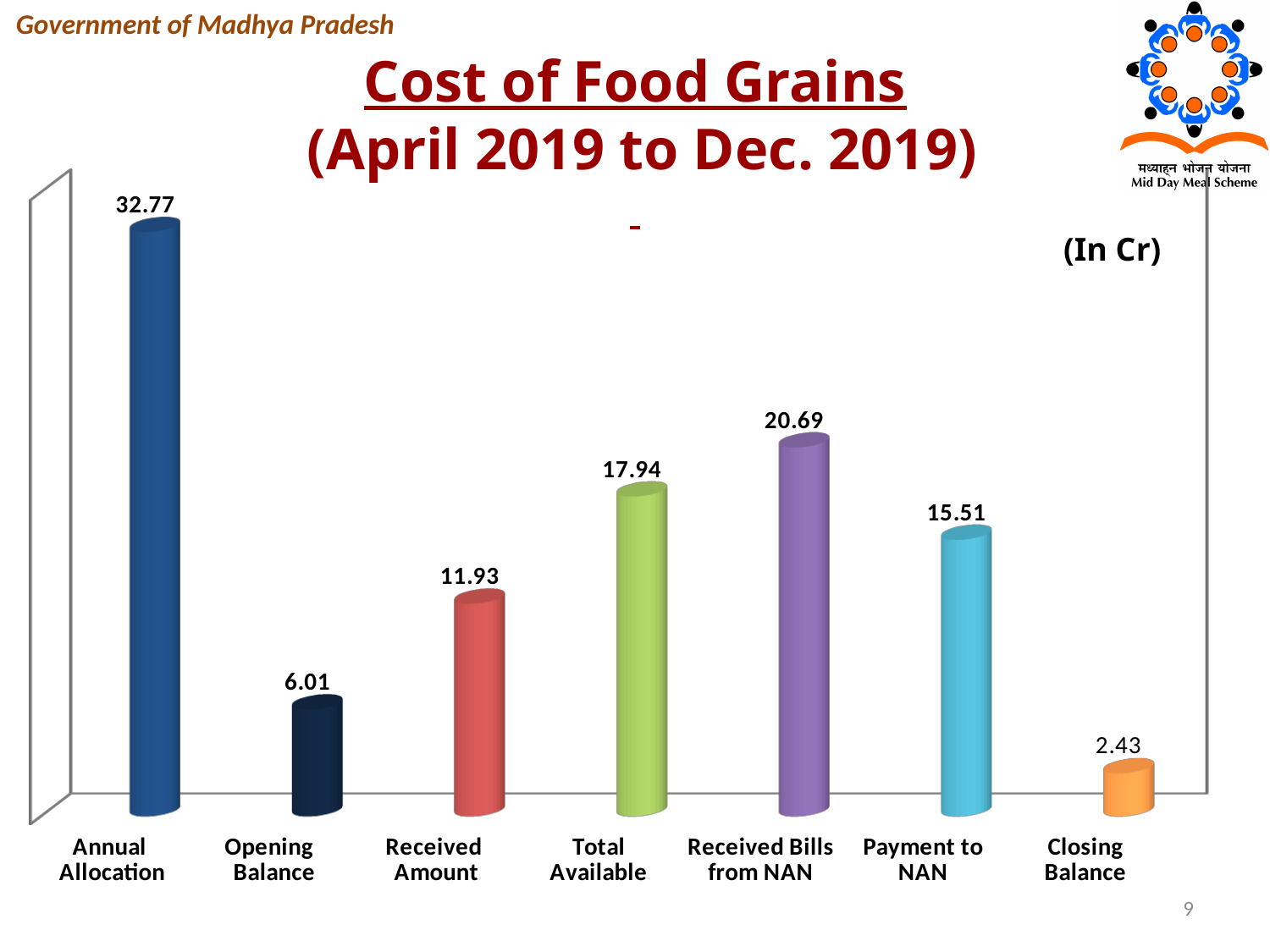
What is the value for Closing Balance? 2.43 Which is larger, Opening Balance or Received Amount? Received Amount What is the difference between Total Available and Received Amount? 6.01 Which category has the highest value? Annual Allocation What unit is indicated for the values in the chart? In Cr Which category has the lowest value? Closing Balance What is the difference between Received Bills from NAN and Payment to NAN? 5.18 How many categories are shown in the chart? 7 What is the value for Total Available? 17.94 What is the value for Annual Allocation? 32.77 What kind of chart is shown on the slide? Bar chart What is the value for Received Bills from NAN? 20.69